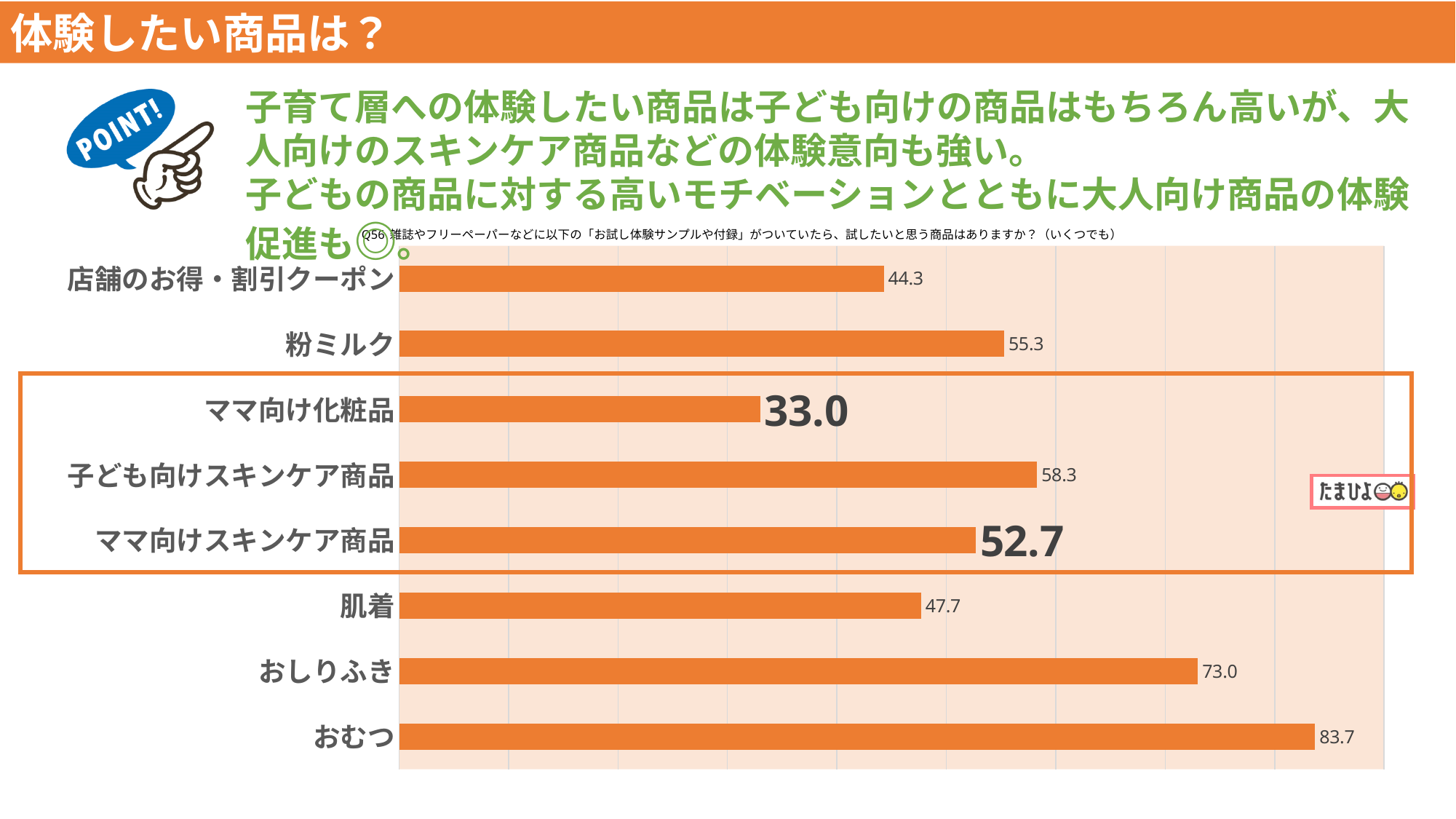
What kind of chart is shown on the slide? bar chart What is the difference between the values for 子ども向けスキンケア商品 and ママ向けスキンケア商品? 5.6 Which category has the lowest value? ママ向け化粧品 What is the value for 店舗のお得・割引クーポン? 44.3 Which is larger, the value for 粉ミルク or the value for 肌着? 粉ミルク What is the difference between the values for おむつ and おしりふき? 10.7 What is the value for ママ向け化粧品? 33.0 What is the value for 子ども向けスキンケア商品? 58.3 Which category has the highest value? おむつ What is the value for おむつ? 83.7 How many categories are shown in the chart? 8 What colour are the bars in the chart? orange